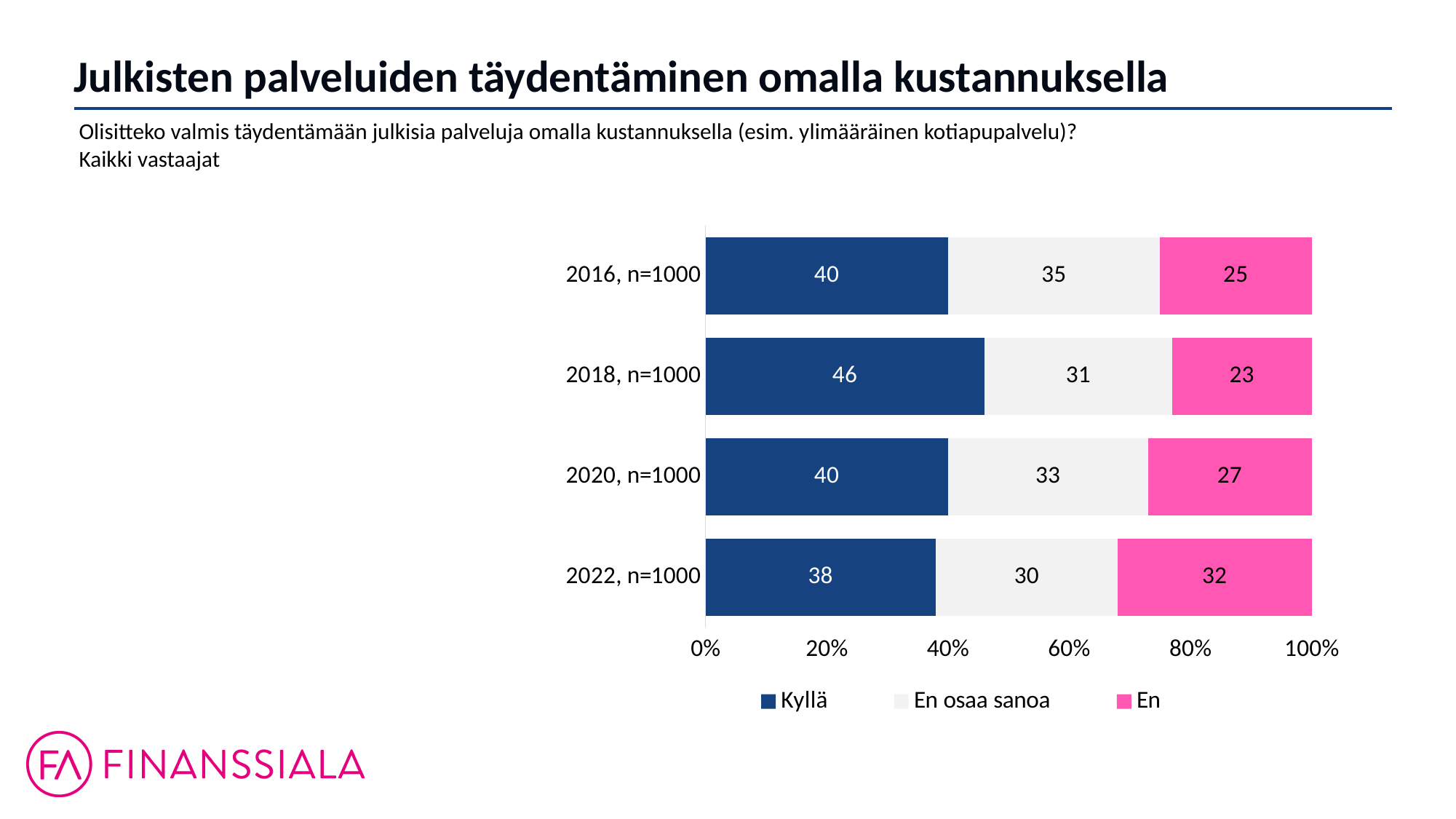
Which year has the lowest value for En? 2018, n=1000 Does the value for En osaa sanoa rise or fall from 2016 to 2022? Fall Which is larger: Kyllä in 2022, n=1000 or En in 2022, n=1000? Kyllä in 2022, n=1000 What is the value for En in 2022, n=1000? 32 What is the value for Kyllä in 2018, n=1000? 46 What is the total of the stacked bar for 2020, n=1000? 100 How many series does the legend list? 3 What is the value for En osaa sanoa in 2016, n=1000? 35 What kind of chart is shown on the slide? Stacked bar chart What is the difference between the En values for 2022, n=1000 and 2016, n=1000? 7 How many year categories are shown in the chart? 4 Which year has the highest value for Kyllä? 2018, n=1000